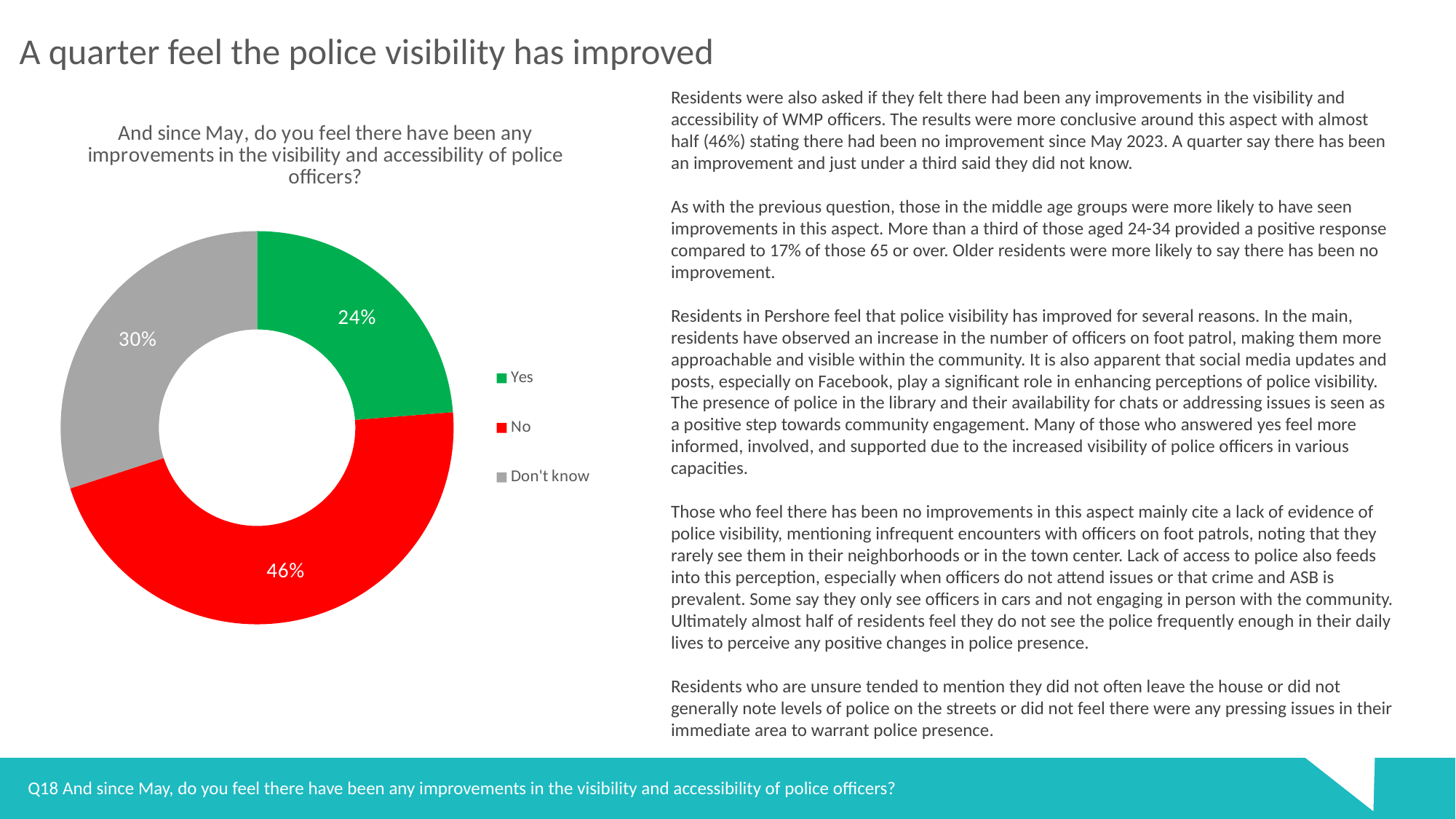
What percentage of respondents answered "Yes"? 24% What kind of chart is shown on the slide? Pie chart (doughnut) What colour is the "Yes" slice in the chart? Green How many response categories does the chart show? 3 Which is larger, the share for "Don't know" or the share for "Yes"? Don't know What is the title of the chart? And since May, do you feel there have been any improvements in the visibility and accessibility of police officers? Which response has the smallest share of the chart? Yes What percentage of respondents answered "Don't know"? 30% What is the difference in percentage points between the "No" and "Yes" responses? 22 What share of the chart does the "No" slice represent? 46% What percentage of respondents answered "No"? 46% Which response has the largest share of the chart? No